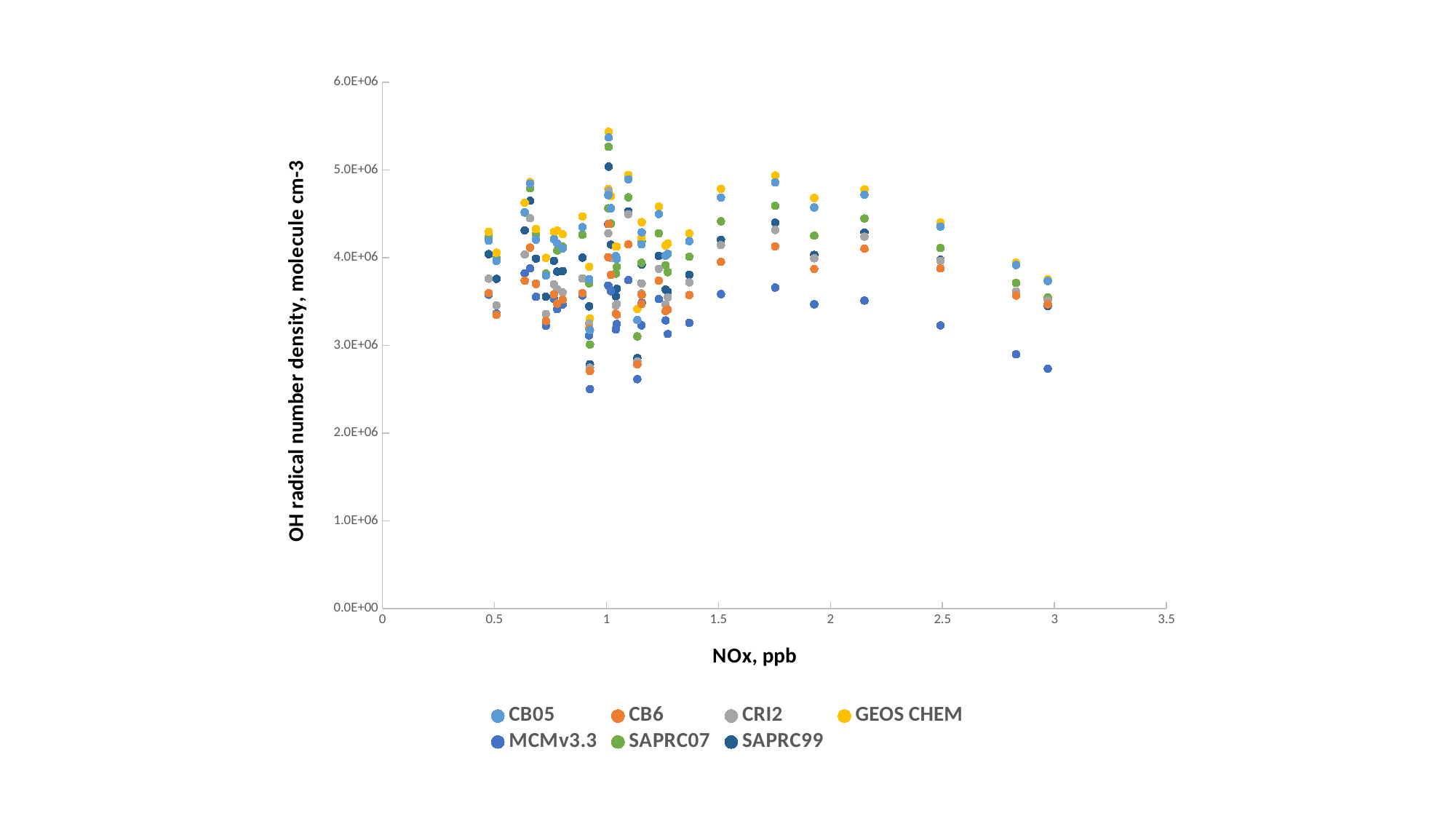
Is the highest GEOS CHEM value near NOx = 1 greater or less than 5.0E+06? greater What is the label of the x axis? NOx, ppb Near NOx = 3, which series has the larger value, GEOS CHEM or MCMv3.3? GEOS CHEM Is the GEOS CHEM value near NOx = 2.5 greater or less than 4.0E+06? greater Which series has the lowest values at NOx values above 2? MCMv3.3 Do the OH radical number density values generally rise or fall as NOx increases beyond 2 ppb? fall What kind of chart is shown on the slide? scatter chart How many series does the legend list? 7 What is the label of the y axis? OH radical number density, molecule cm-3 Is the lowest MCMv3.3 value near NOx = 3 greater or less than 3.0E+06? less Which series has the highest values at NOx values above 2? GEOS CHEM